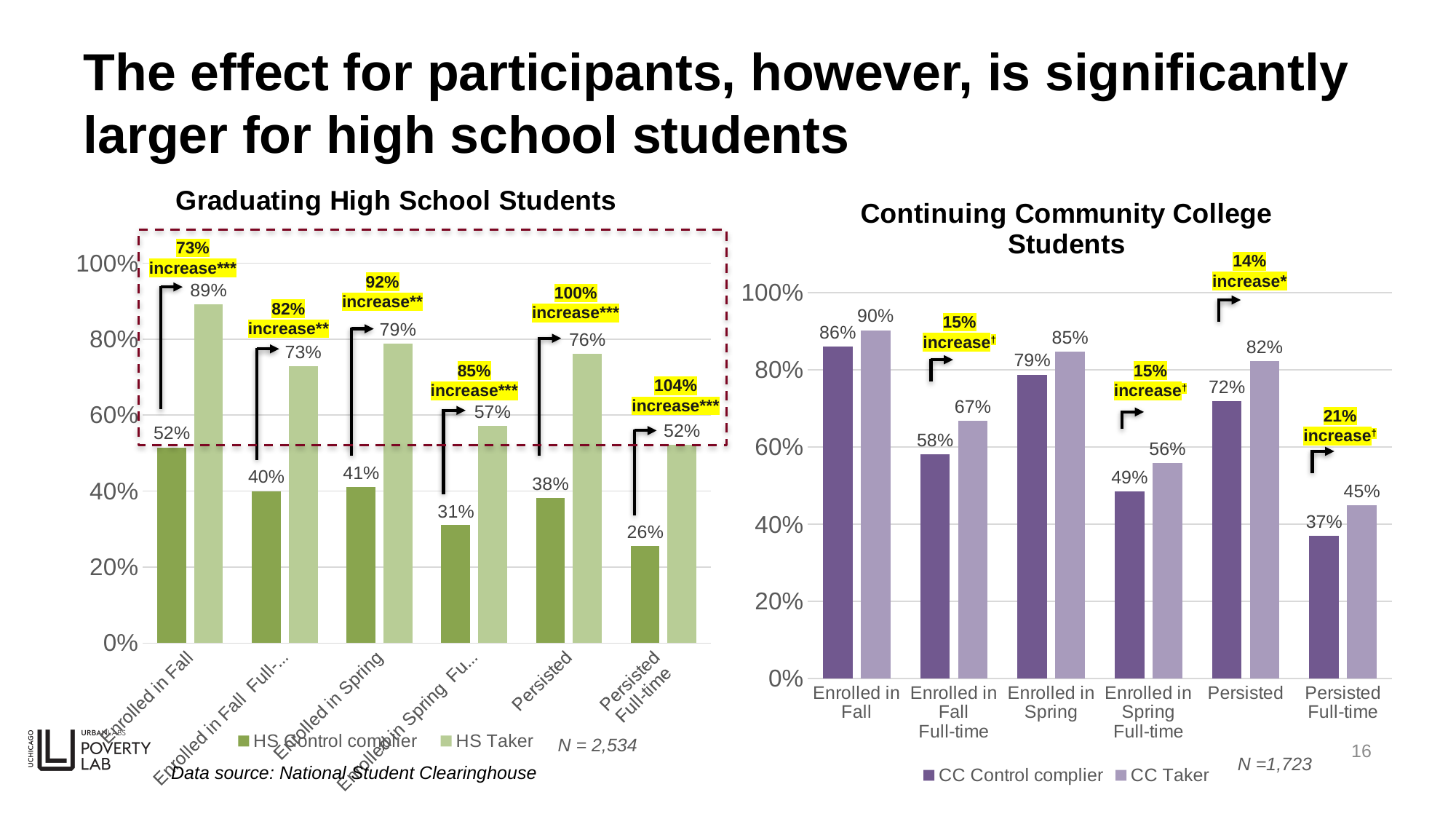
What kind of chart is the Continuing Community College Students chart? Bar chart In the Continuing Community College Students chart, how many categories are shown on the x axis? 6 In the Graduating High School Students chart, which category has the lowest HS Control complier value? Persisted Full-time In the Continuing Community College Students chart, what is the value for CC Control complier for Enrolled in Spring Full-time? 49% In the Continuing Community College Students chart, which category has the highest CC Taker value? Enrolled in Fall In the Continuing Community College Students chart, what is the difference between CC Taker and CC Control complier for Persisted? 10% In the Continuing Community College Students chart, which is larger: CC Control complier for Persisted or CC Control complier for Enrolled in Fall Full-time? Persisted In the Graduating High School Students chart, how many series does the legend list? 2 In the Continuing Community College Students chart, what is the value for CC Taker for Enrolled in Spring? 85% In the Graduating High School Students chart, what is the value for HS Taker for Enrolled in Fall? 89% In the Graduating High School Students chart, what is the difference between HS Taker and HS Control complier for Persisted Full-time? 26% In the Graduating High School Students chart, what is the value for HS Control complier for Persisted? 38%